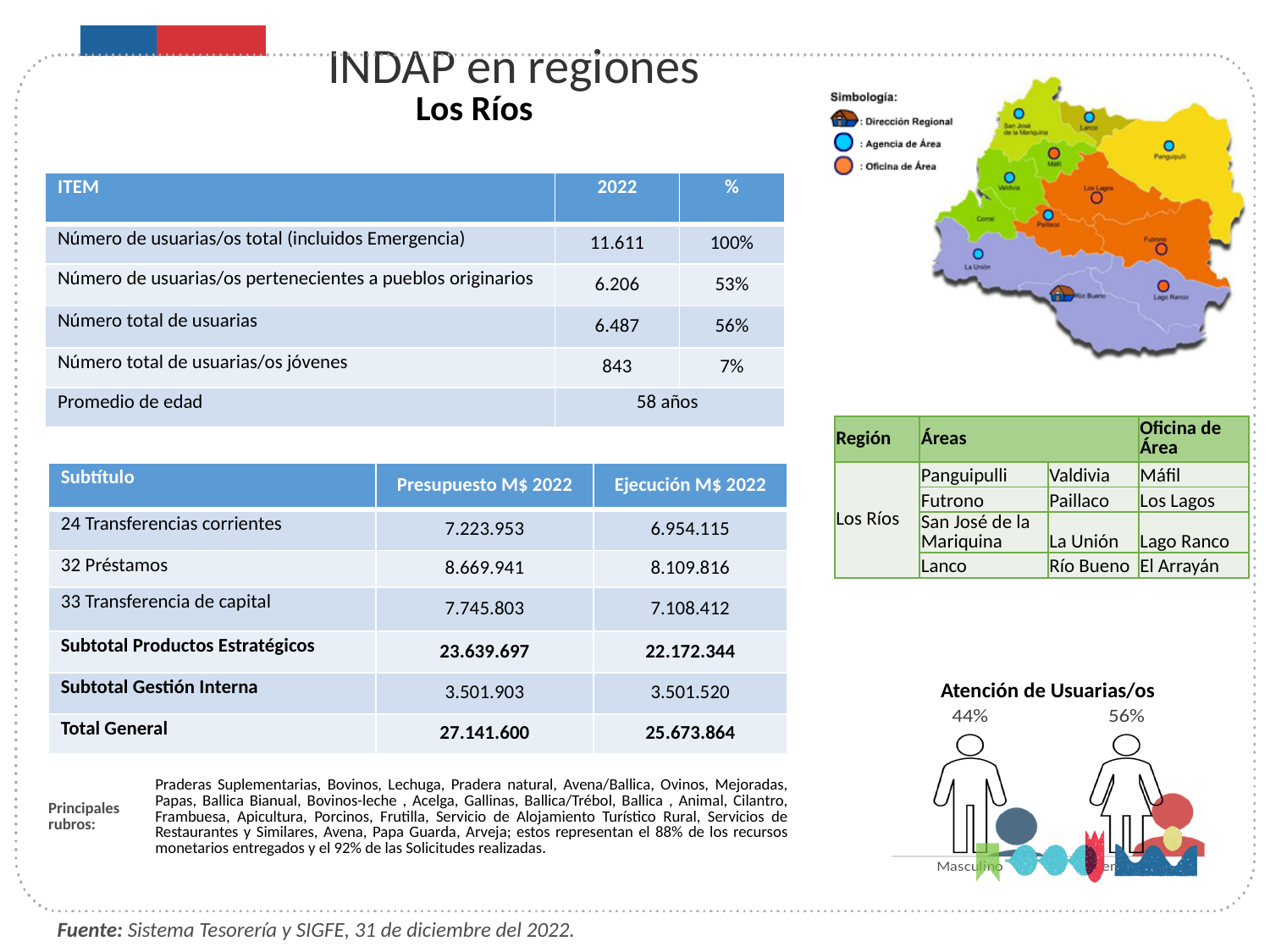
How many categories are shown in the chart titled "Atención de Usuarias/os"? 2 What kind of chart is "Atención de Usuarias/os"? Bar chart (pictogram style with person icons) What is the title of the chart in the lower right of the slide? Atención de Usuarias/os In the chart titled "Atención de Usuarias/os", is the Masculino value larger or smaller than the female figure's value? Smaller In the chart titled "Atención de Usuarias/os", which category has the lowest value? Masculino (44%) In the chart titled "Atención de Usuarias/os", what is the value shown above the female figure on the right? 56% In the chart titled "Atención de Usuarias/os", what do the two percentages add up to? 100% In the chart titled "Atención de Usuarias/os", which of the two categories has the higher value? The female figure (56%) In the chart titled "Atención de Usuarias/os", what is the difference in percentage points between the female figure's value and the Masculino value? 12 percentage points In the chart titled "Atención de Usuarias/os", what is the value shown for Masculino? 44%